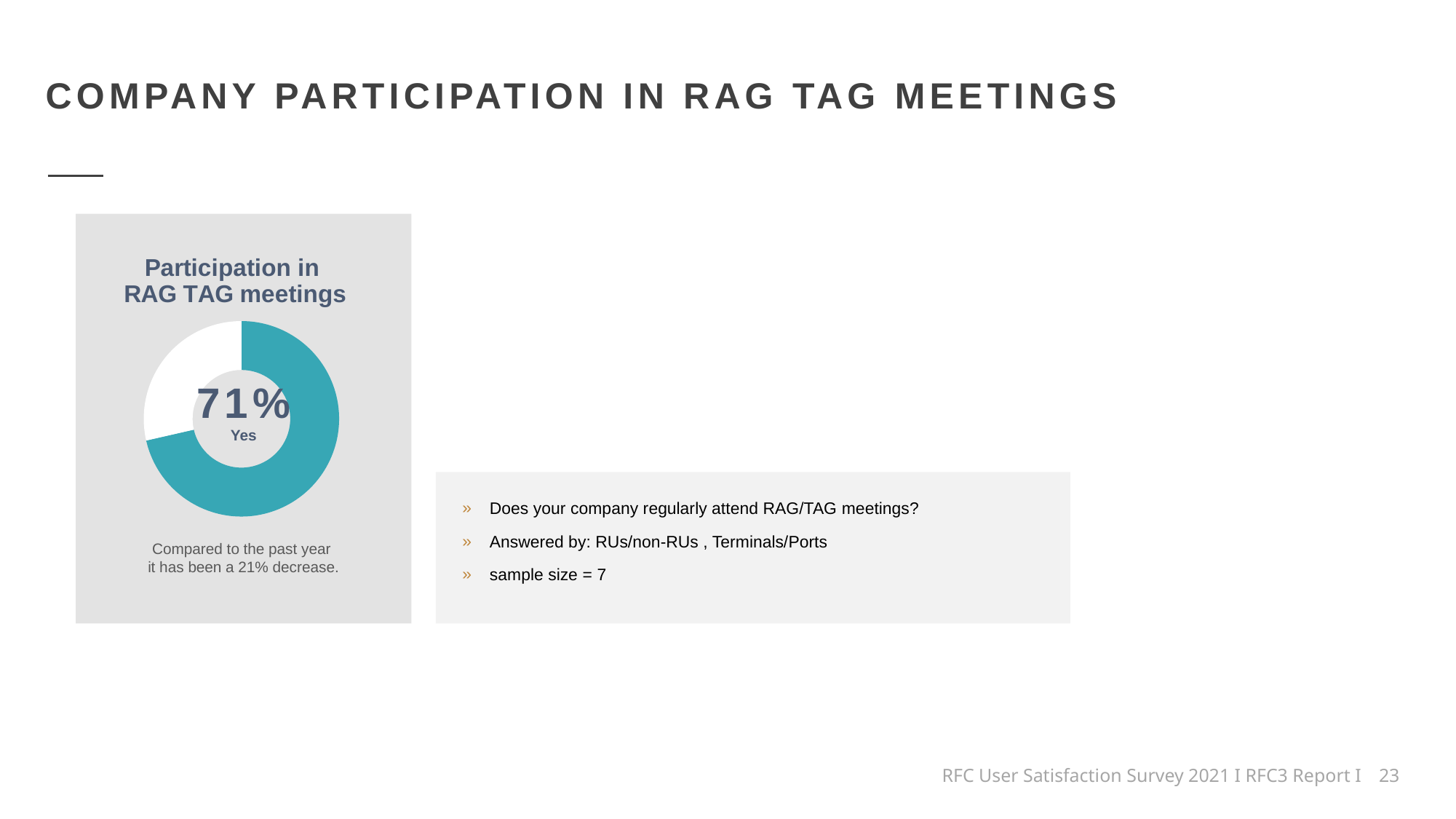
How many segments does the donut chart have? 2 What is the title of the chart? Participation in RAG TAG meetings Is the Yes share in the donut chart greater or less than 50%? greater What colour is the Yes segment of the donut chart? Teal What kind of chart is shown on the slide? Donut (pie) chart According to the caption under the chart, how has participation changed compared to the past year? A 21% decrease What percentage of companies answered Yes to regularly attending RAG TAG meetings? 71% What is the sample size for the chart's survey question? 7 Which portion of the donut chart is larger, the Yes portion or the remaining portion? Yes